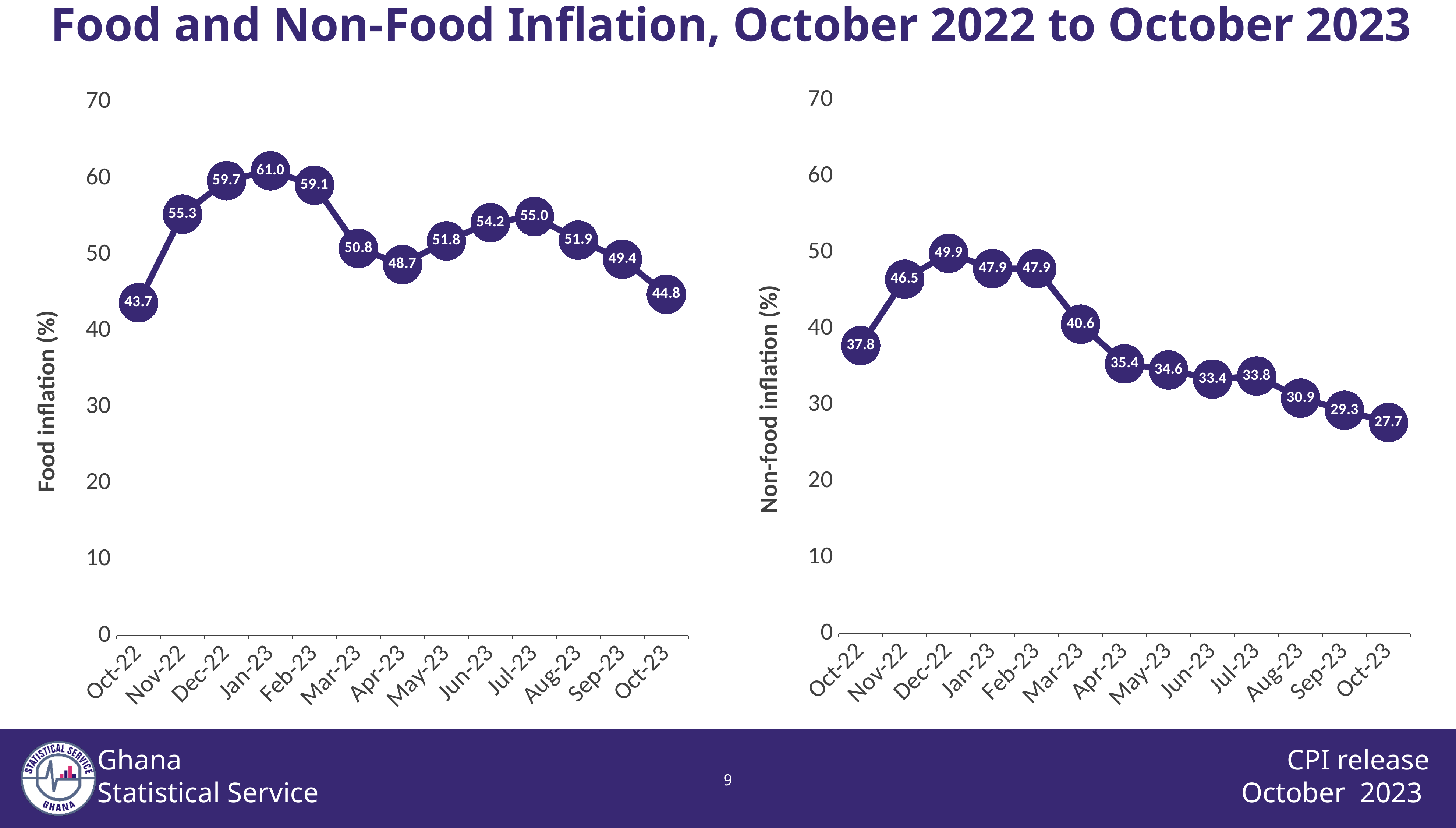
In the left chart (Food inflation), which month has the highest value? Jan-23 In the right chart (Non-food inflation), which month has the lowest value? Oct-23 In the right chart (Non-food inflation), do the values rise or fall from Feb-23 to Oct-23? Fall In the right chart (Non-food inflation), what is the difference between the Dec-22 and Oct-23 values? 22.2 How many data points are plotted in the left chart (Food inflation)? 13 In the left chart (Food inflation), which is larger, the value for Jul-23 or the value for Mar-23? Jul-23 In the left chart (Food inflation), what is the value for Jan-23? 61.0 In the right chart (Non-food inflation), what is the value for Oct-23? 27.7 In the left chart (Food inflation), what is the difference between the Oct-22 and Oct-23 values? 1.1 What is the y-axis label of the left chart? Food inflation (%) What kind of chart is the right chart (Non-food inflation)? Line chart In the right chart (Non-food inflation), is the value for Mar-23 greater or less than 40? greater